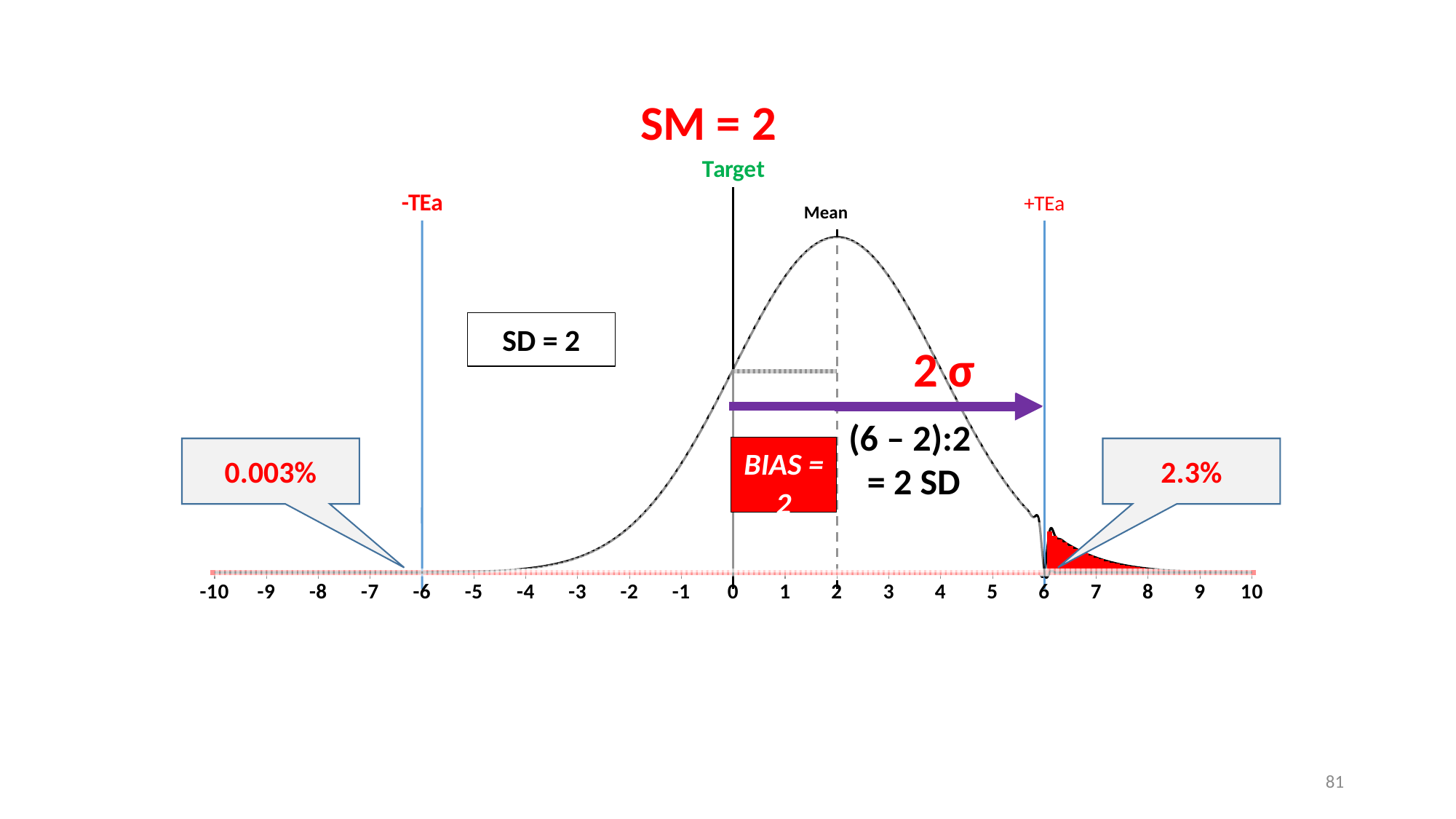
What percentage is shown in the callout pointing to the left tail beyond -TEa? 0.003% What is the BIAS value stated in the red box on the chart? 2 What kind of chart is shown on the slide? Line chart (bell curve) What is the SD value stated in the box on the chart? SD = 2 What is the difference between the right-tail percentage and the left-tail percentage? 2.297% At what x-axis value is the Mean line located? 2 Which tail has the larger percentage shown, the left tail or the right tail? Right tail At what x-axis value is the +TEa line located? 6 What percentage is shown in the callout pointing to the right tail beyond +TEa? 2.3% At what x-axis value is the -TEa line located? -6 How many tick labels are shown on the x-axis? 21 At what x-axis value is the Target line located? 0